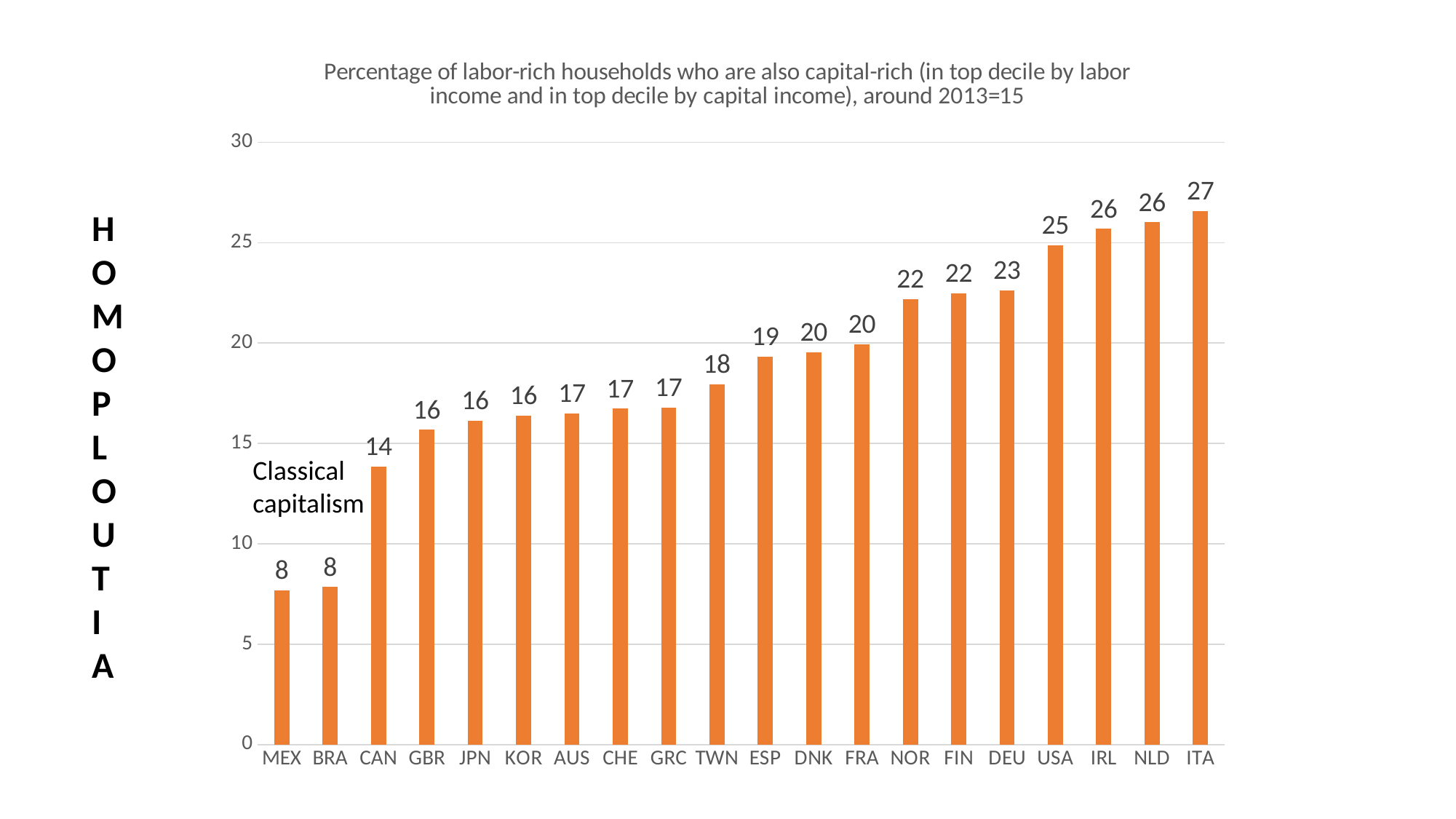
What kind of chart is this? bar chart What annotation text is placed near the MEX and BRA bars? Classical capitalism How many countries are shown on the x axis? 20 Which has a larger value, USA or DEU? USA What is the value for USA? 25 Do the values rise or fall from left to right along the x axis? rise Is the value for ESP greater or less than 15? greater What is the difference between the values for ITA and MEX? 19 What is the value for CAN? 14 What is the value for TWN? 18 What is the difference between the values for USA and CAN? 11 Which country has the highest value? ITA